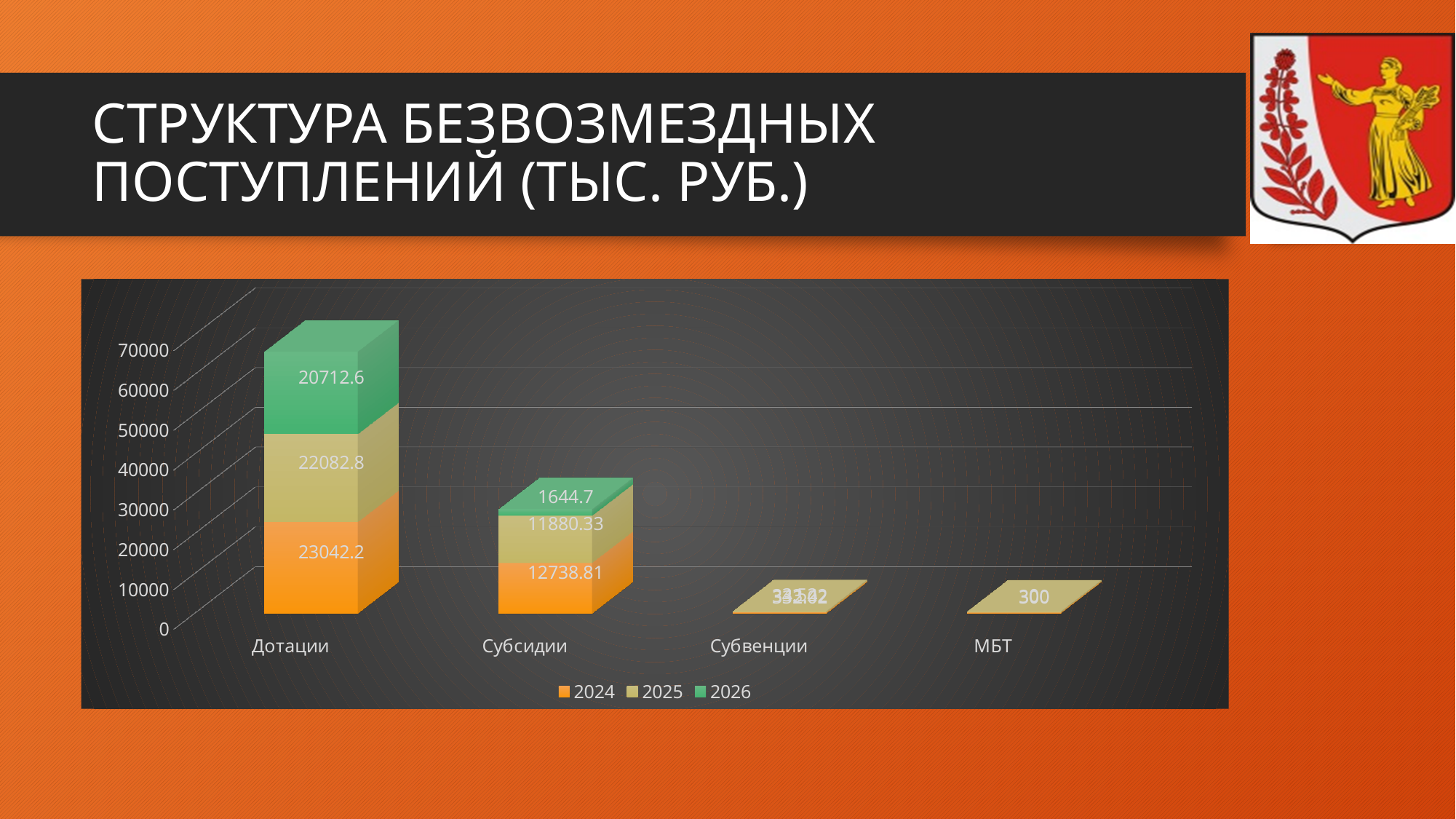
What is the total of the stacked bar for Дотации? 65837.6 What is the value for Дотации in the 2024 series? 23042.2 Is the total stacked bar for Субсидии greater or less than 20000? greater What is the value for Субсидии in the 2025 series? 11880.33 What is the difference between the 2024 and 2025 values for Дотации? 959.4 What is the value for Дотации in the 2026 series? 20712.6 What is the value for Субсидии in the 2026 series? 1644.7 How many series does the chart legend list? 3 What type of chart is shown on the slide? Stacked bar chart How many categories are shown on the x axis of the chart? 4 Which is larger: the 2024 value for Субсидии or the 2025 value for Субсидии? 2024 value for Субсидии (12738.81) Which category has the highest total stacked bar? Дотации